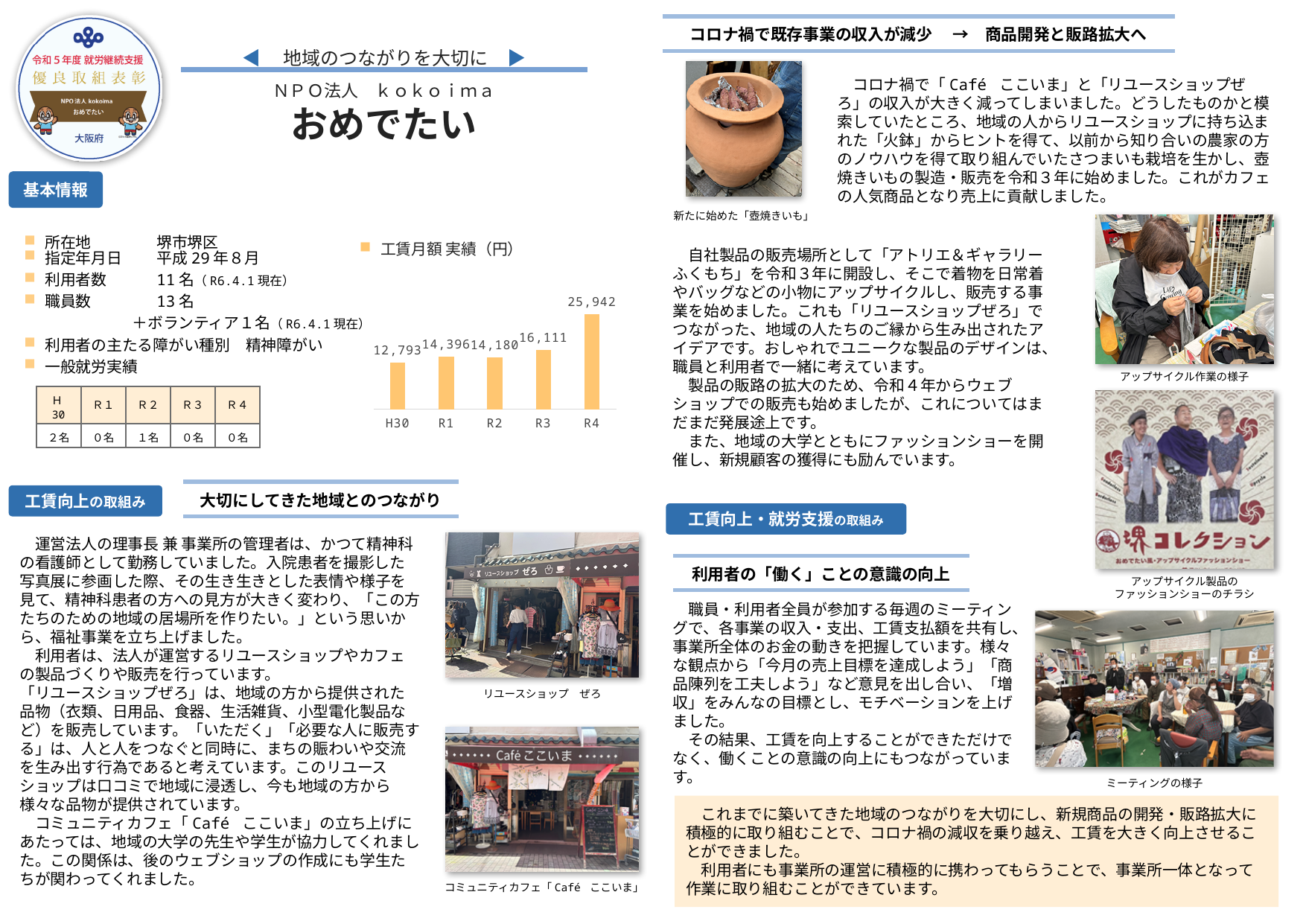
Which category has the highest value in the 工賃月額 実績（円） chart? R4 What is the title of the chart on the slide? 工賃月額 実績（円） How many categories are shown on the x axis of the 工賃月額 実績（円） chart? 5 What is the difference between the R4 and R3 values in the 工賃月額 実績（円） chart? 9,831 What is the value for H30 in the 工賃月額 実績（円） chart? 12,793 What is the value for R3 in the 工賃月額 実績（円） chart? 16,111 In the 工賃月額 実績（円） chart, which is larger, the value for R1 or the value for R3? R3 Which category has the lowest value in the 工賃月額 実績（円） chart? H30 What is the value for R2 in the 工賃月額 実績（円） chart? 14,180 What is the value for R4 in the 工賃月額 実績（円） chart? 25,942 What kind of chart is the 工賃月額 実績（円） chart? bar chart What is the difference between the R1 and H30 values in the 工賃月額 実績（円） chart? 1,603